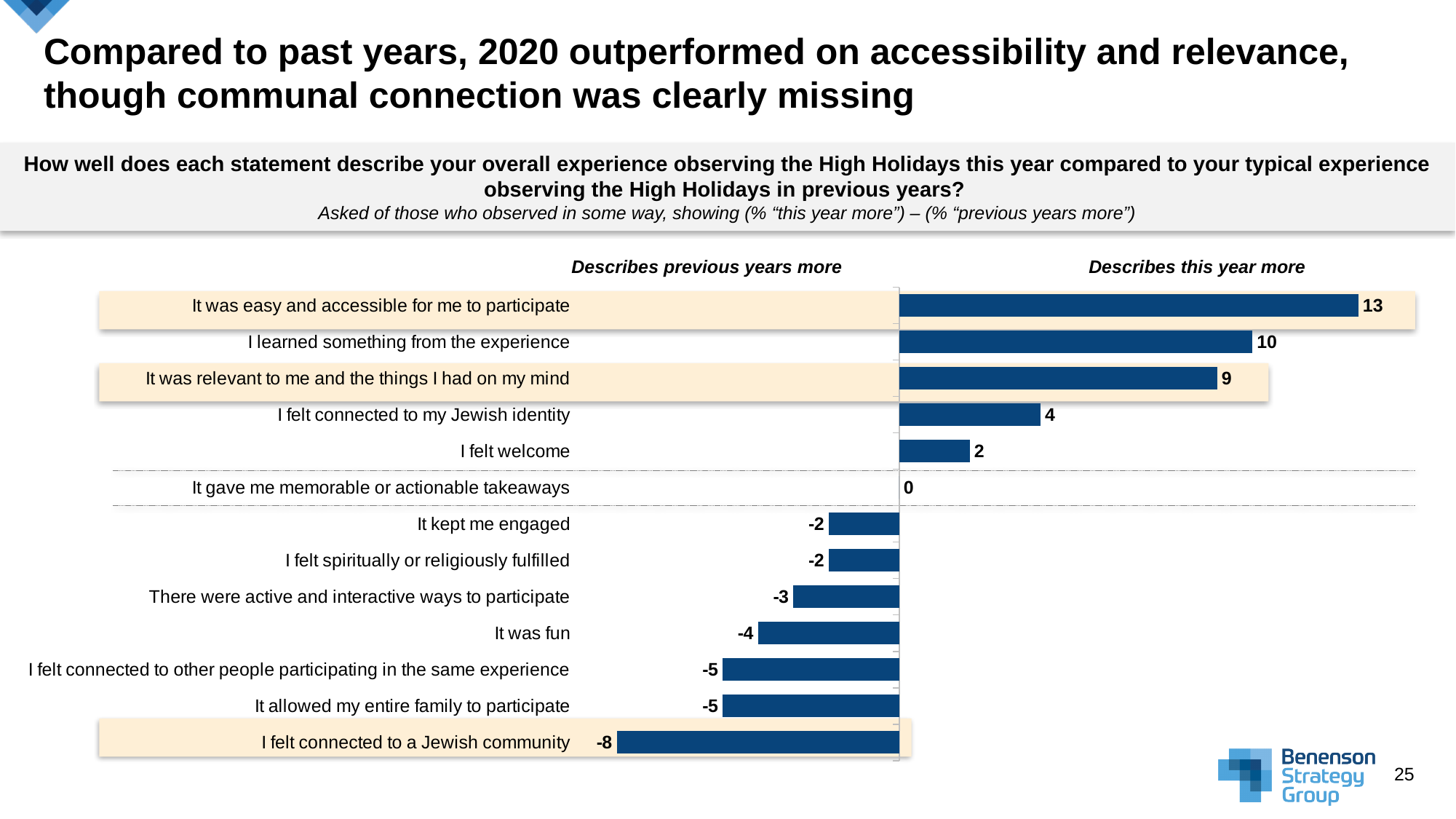
Which statement has the highest value? It was easy and accessible for me to participate What is the value for "It gave me memorable or actionable takeaways"? 0 What is the difference between the values for "I learned something from the experience" and "It was relevant to me and the things I had on my mind"? 1 Which statement has the lowest value? I felt connected to a Jewish community How many statements are plotted in the chart? 13 What kind of chart is shown on the slide? Bar chart What does the label on the right side of the chart say? Describes this year more What is the value for "I felt connected to my Jewish identity"? 4 What is the value for "It was easy and accessible for me to participate"? 13 What is the value for "I felt connected to a Jewish community"? -8 How many statements have a negative value? 7 Which has a larger value: "I felt welcome" or "It was fun"? I felt welcome